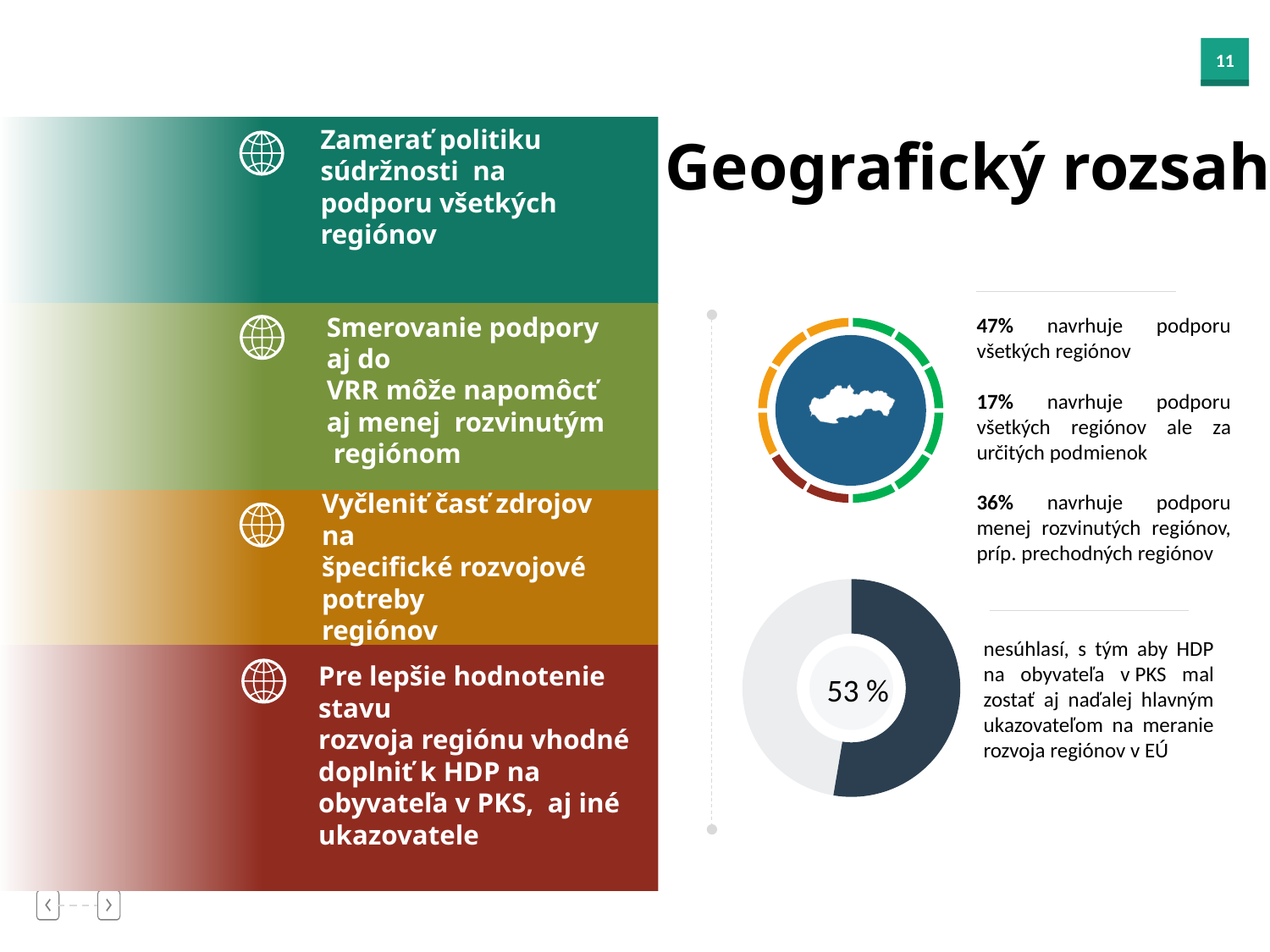
What share of the donut chart does the dark blue slice represent? 53 % How many slices does the donut chart showing 53 % have? 2 What kind of chart is the chart at the bottom of the slide showing 53 %? Donut (pie) chart What colour is the larger slice of the donut chart? Dark blue On the donut chart at the bottom of the slide, what value is printed in the centre? 53 % On the donut chart showing 53 %, which slice is larger, the dark blue one or the light grey one? The dark blue one On the donut chart, is the dark blue slice's share greater or less than 50%? greater